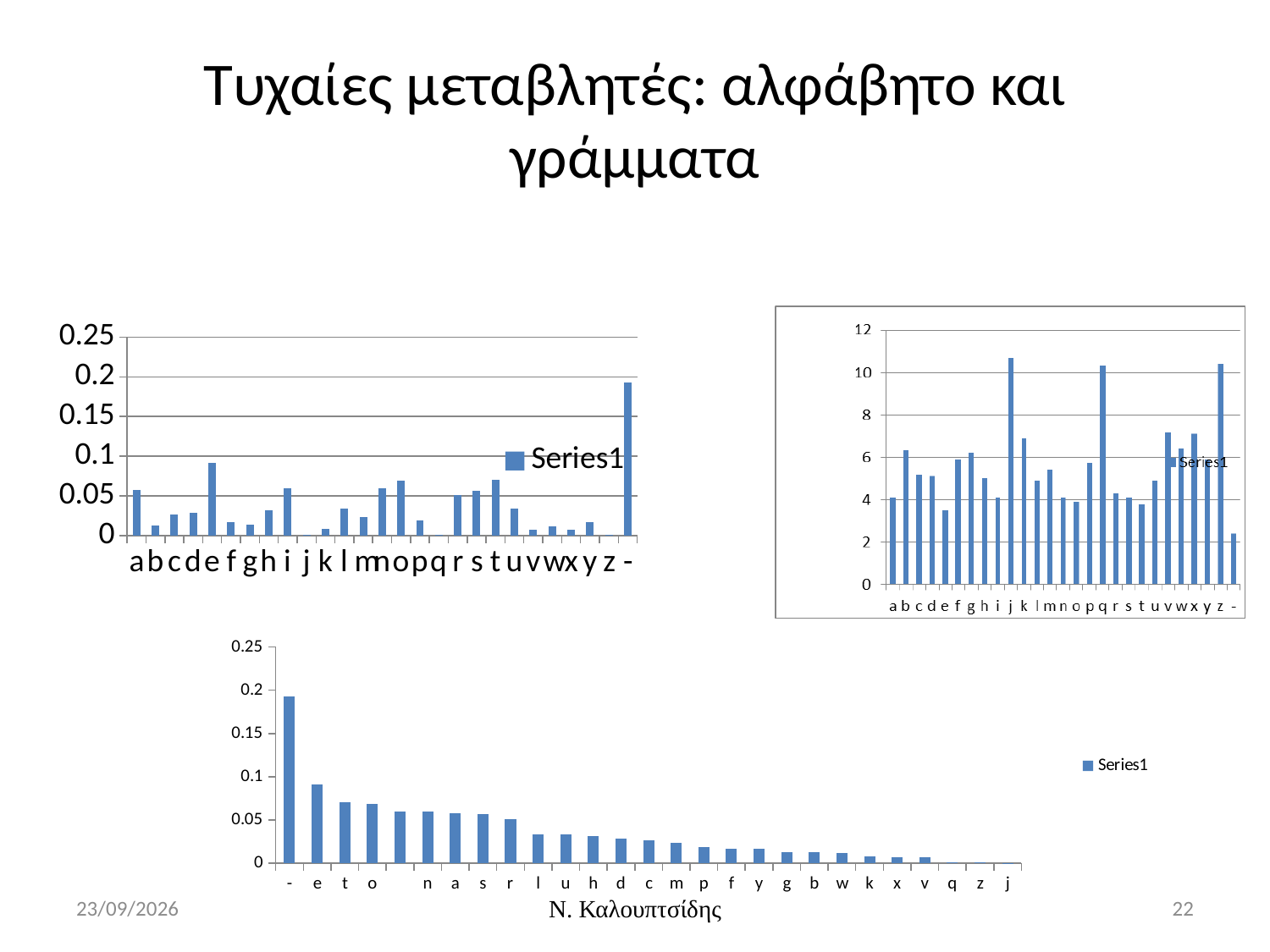
How many categories are shown on the x axis of the bottom chart? 27 How many series does the legend of the top-left chart list? 1 In the top-right chart, which category has the lowest value? - In the top-left chart, is the value for '-' greater or less than 0.15? greater In the top-right chart, is the value for 'a' greater or less than 6? less In the top-right chart, is the value for 'j' greater or less than 10? greater What kind of chart is the top-left chart? bar chart In the bottom chart, do the values rise or fall from left to right along the x axis? fall In the top-right chart, which is larger, the value for 'j' or the value for 'a'? j In the top-left chart, which category has the highest value? -